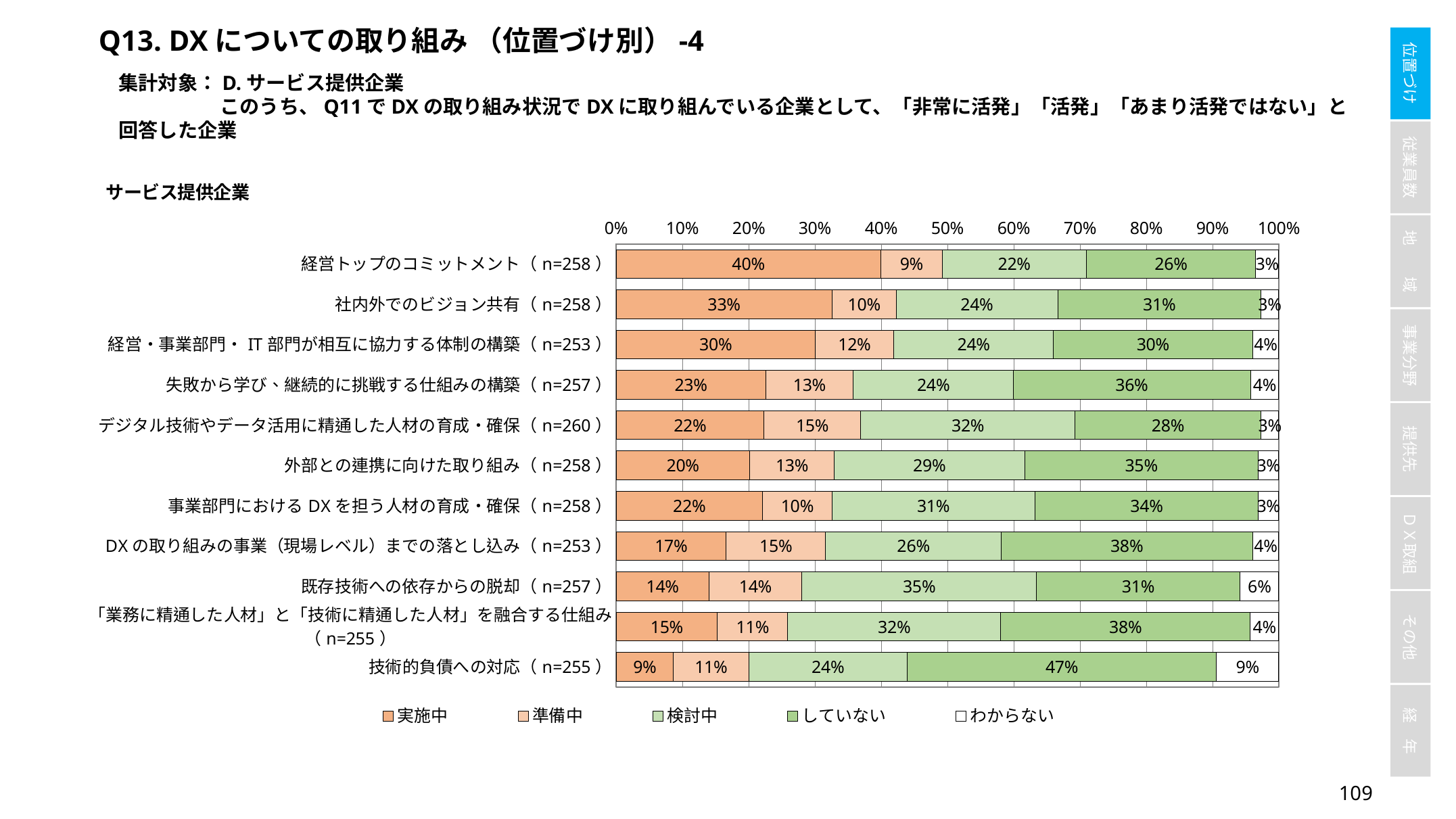
What is the difference between the 実施中 values for 経営トップのコミットメント and 社内外でのビジョン共有? 7% What is the していない value for 技術的負債への対応? 47% Which category has the lowest 実施中 value? 技術的負債への対応 How many series does the legend list? 5 What is the 検討中 value for 既存技術への依存からの脱却? 35% What is the label of the first (leftmost) series in the legend? 実施中 What is the 実施中 value for 経営トップのコミットメント? 40% How many categories (items) are plotted in the chart? 11 What kind of chart is shown on the slide? Stacked bar chart Which is larger: the 準備中 value for デジタル技術やデータ活用に精通した人材の育成・確保 or for 事業部門におけるDXを担う人材の育成・確保? デジタル技術やデータ活用に精通した人材の育成・確保 What is the わからない value for 既存技術への依存からの脱却? 6% Which category has the highest 実施中 value? 経営トップのコミットメント